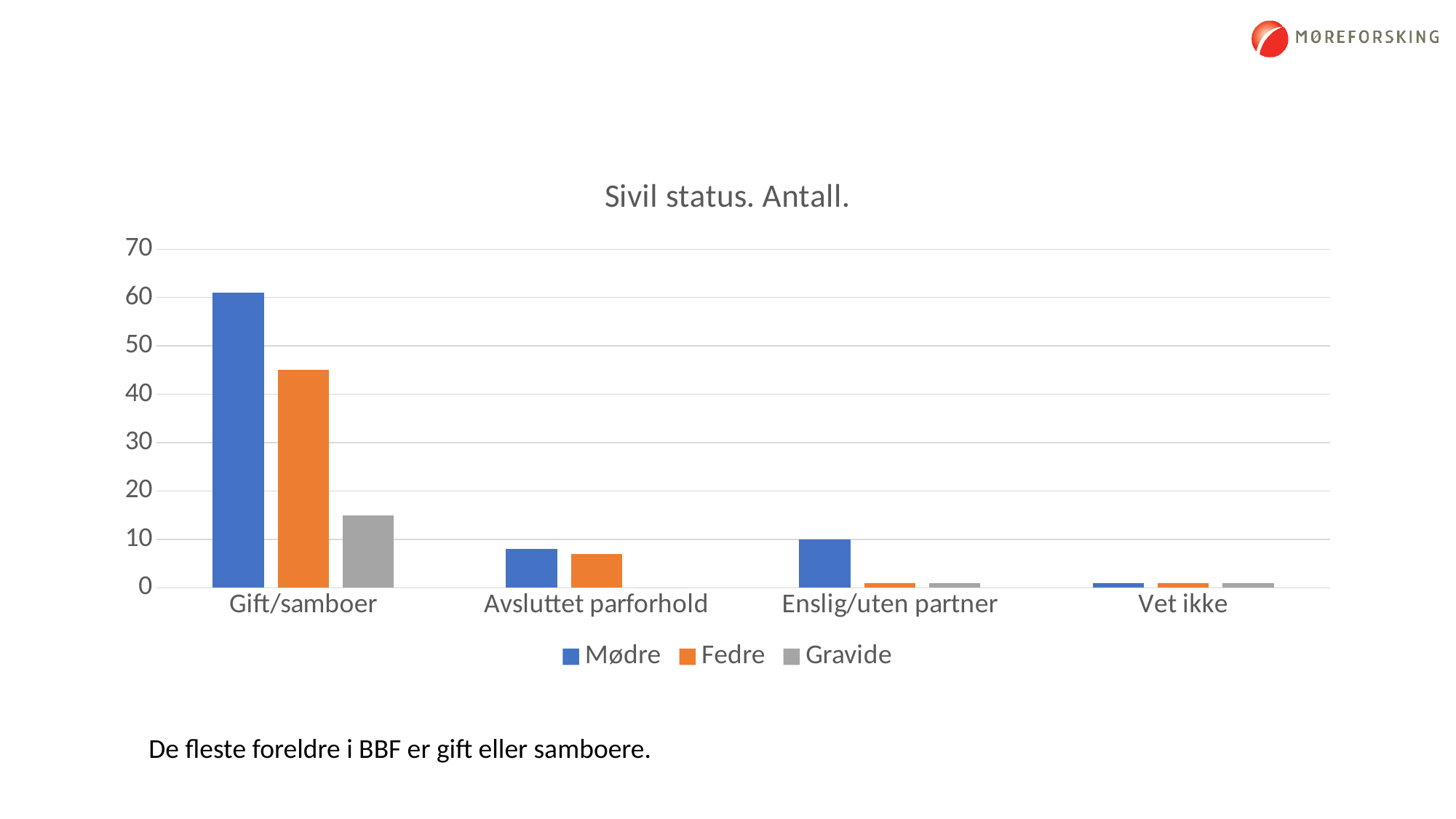
In Gift/samboer, which series has the larger value, Mødre or Fedre? Mødre What kind of chart is shown on the slide? bar chart Which category has the highest value for Mødre? Gift/samboer Is the value for Gravide in Gift/samboer greater or less than 20? less What is the title of the chart? Sivil status. Antall. Which series is shown in orange in the legend? Fedre How many categories are shown on the x axis? 4 In Enslig/uten partner, which series has the larger value, Mødre or Fedre? Mødre Which category has the highest value for Fedre? Gift/samboer How many series does the legend list? 3 Is the value for Fedre in Gift/samboer greater or less than 40? greater